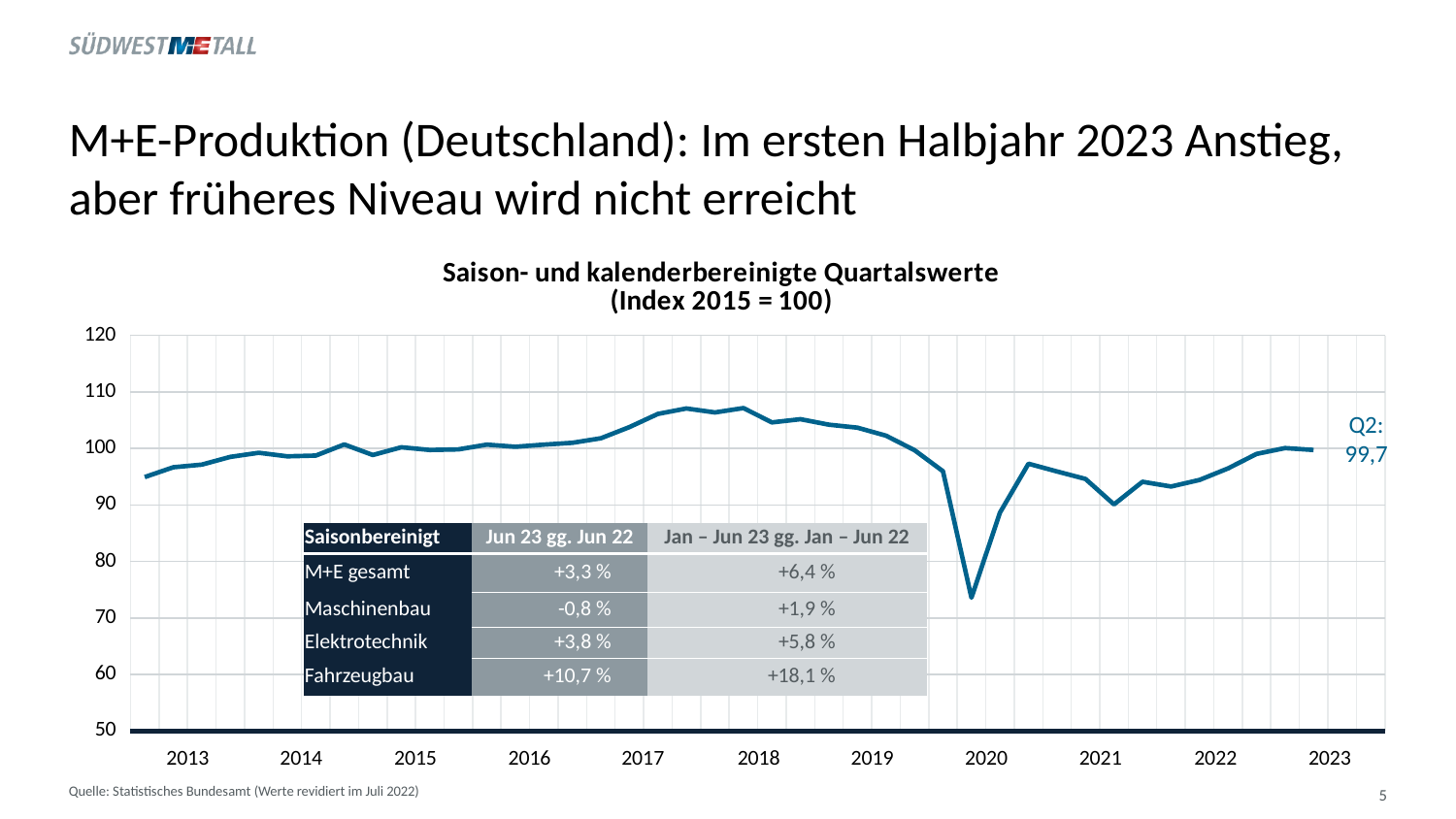
Is the peak value of the line around 2018 greater or less than 100? greater In which year does the line reach its lowest point? 2020 Is the value in early 2021 greater or less than 100? less What kind of chart is shown on the slide? line chart Does the line rise or fall between 2018 and 2020? fall Is the value at the start of 2013 greater or less than 100? less Does the line rise or fall between 2013 and 2018? rise What is the first year shown on the x axis? 2013 What value is labelled for Q2 2023 on the chart? 99,7 What is the title of the chart? Saison- und kalenderbereinigte Quartalswerte (Index 2015 = 100) Which is higher: the value around 2018 or the value in Q2 2023? 2018